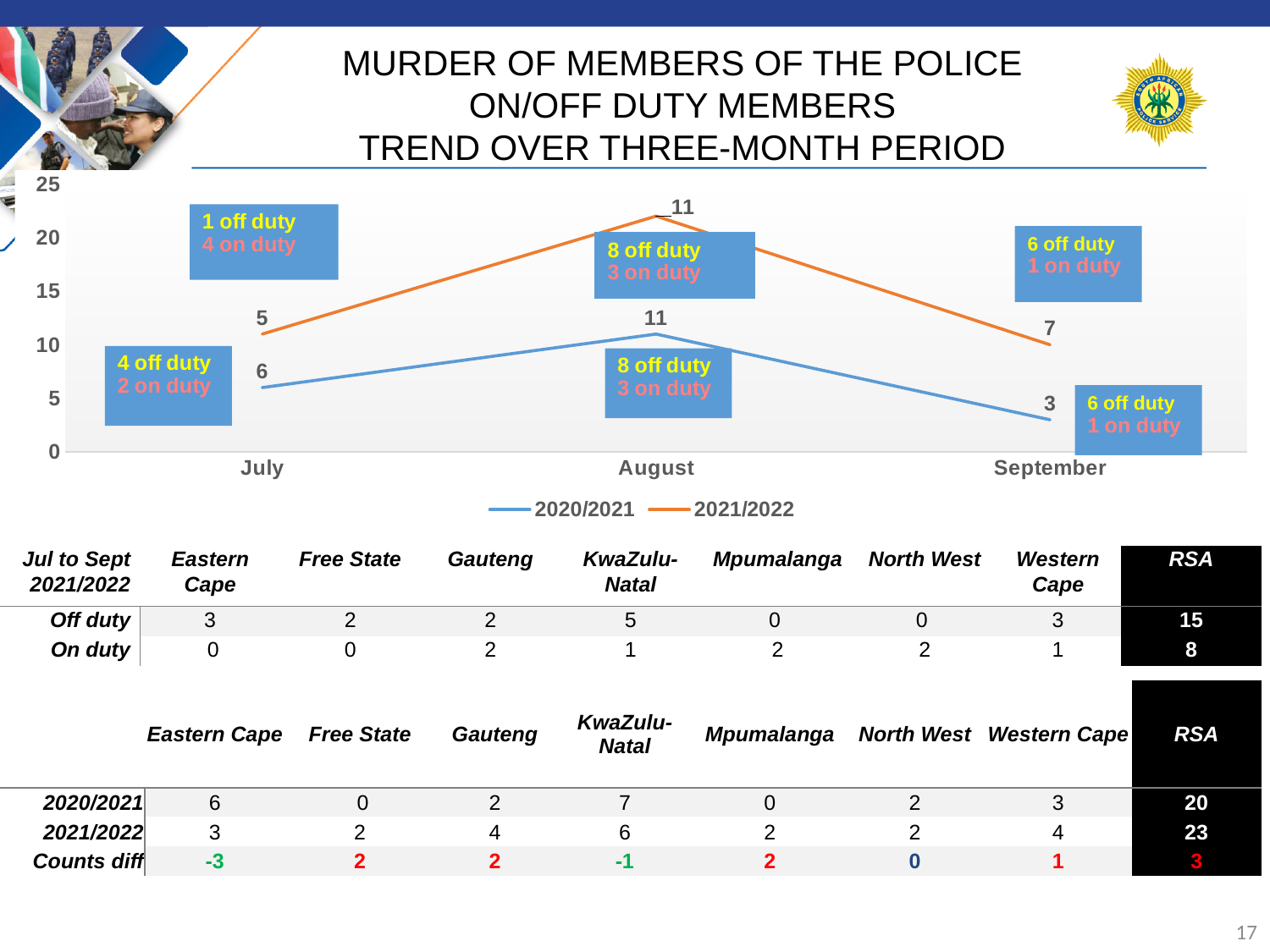
How many series does the legend list? 2 How many months are shown on the x axis? 3 What is the value for 2020/2021 in September? 3 In July, which series has the larger value, 2020/2021 or 2021/2022? 2020/2021 What is the value for 2020/2021 in August? 11 In which month is the 2020/2021 value lowest? September In which month is the 2020/2021 value highest? August What kind of chart is shown on the slide? Line chart What is the difference between the 2021/2022 and 2020/2021 values in September? 4 What is the value for 2021/2022 in September? 7 What is the value for 2020/2021 in July? 6 What is the value for 2021/2022 in July? 5